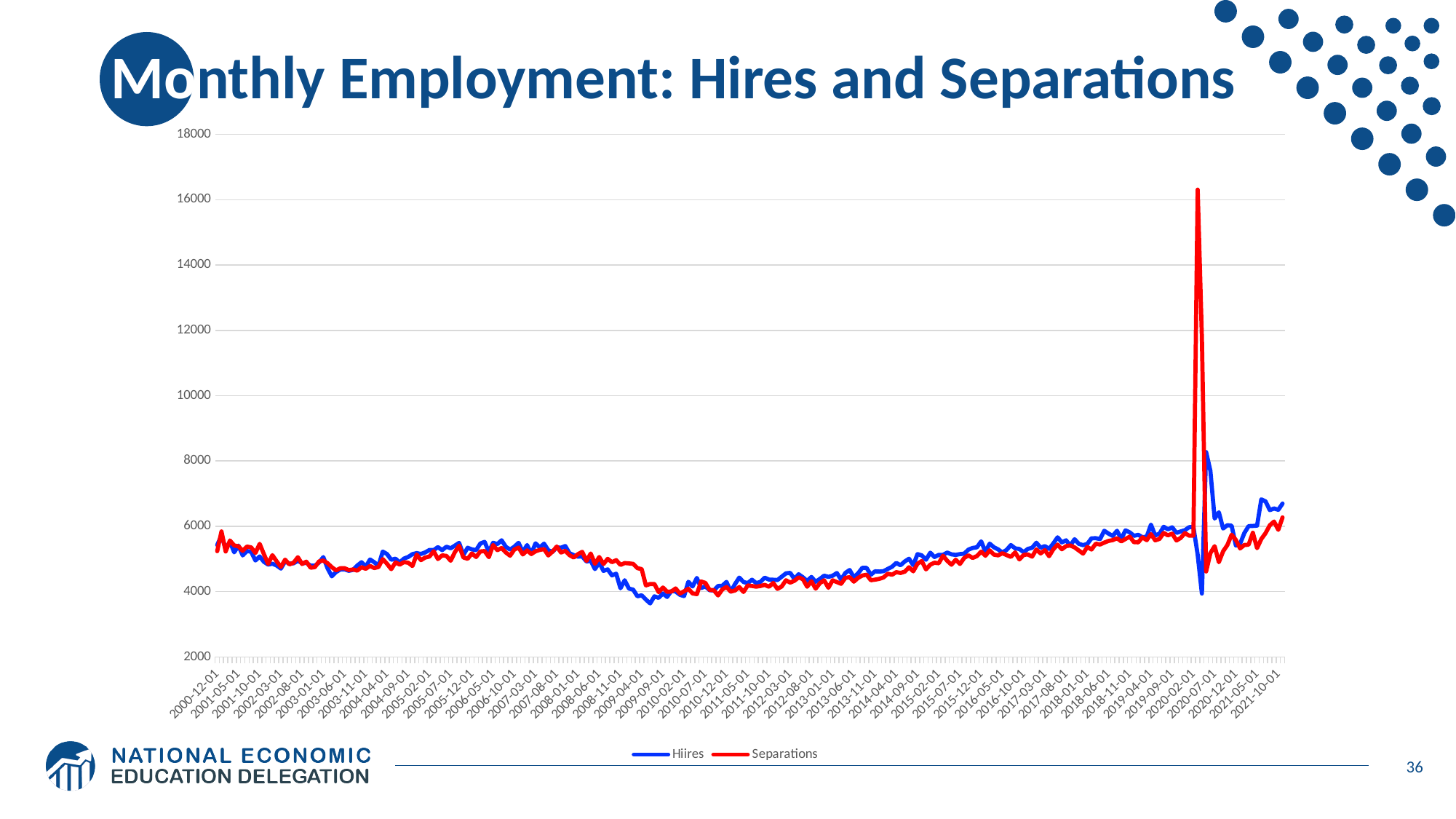
Do the Hiires values rise or fall between 2010-07-01 and 2019-09-01? rise Is the lowest value of the Hiires series in 2020 greater or less than 6000? less Around 2020-04-01, which series has the larger value, Hiires or Separations? Separations What kind of chart is shown on the slide? line chart How many series does the legend list? 2 What are the two series named in the legend? Hiires and Separations Is the value for Hiires at 2000-12-01 greater or less than 4000? greater Is the peak value of the Separations series in 2020 greater or less than 14000? greater What colour is the Separations line? red Which series reaches the highest value on the chart? Separations Do the Hiires values rise or fall between 2008-01-01 and 2009-04-01? fall